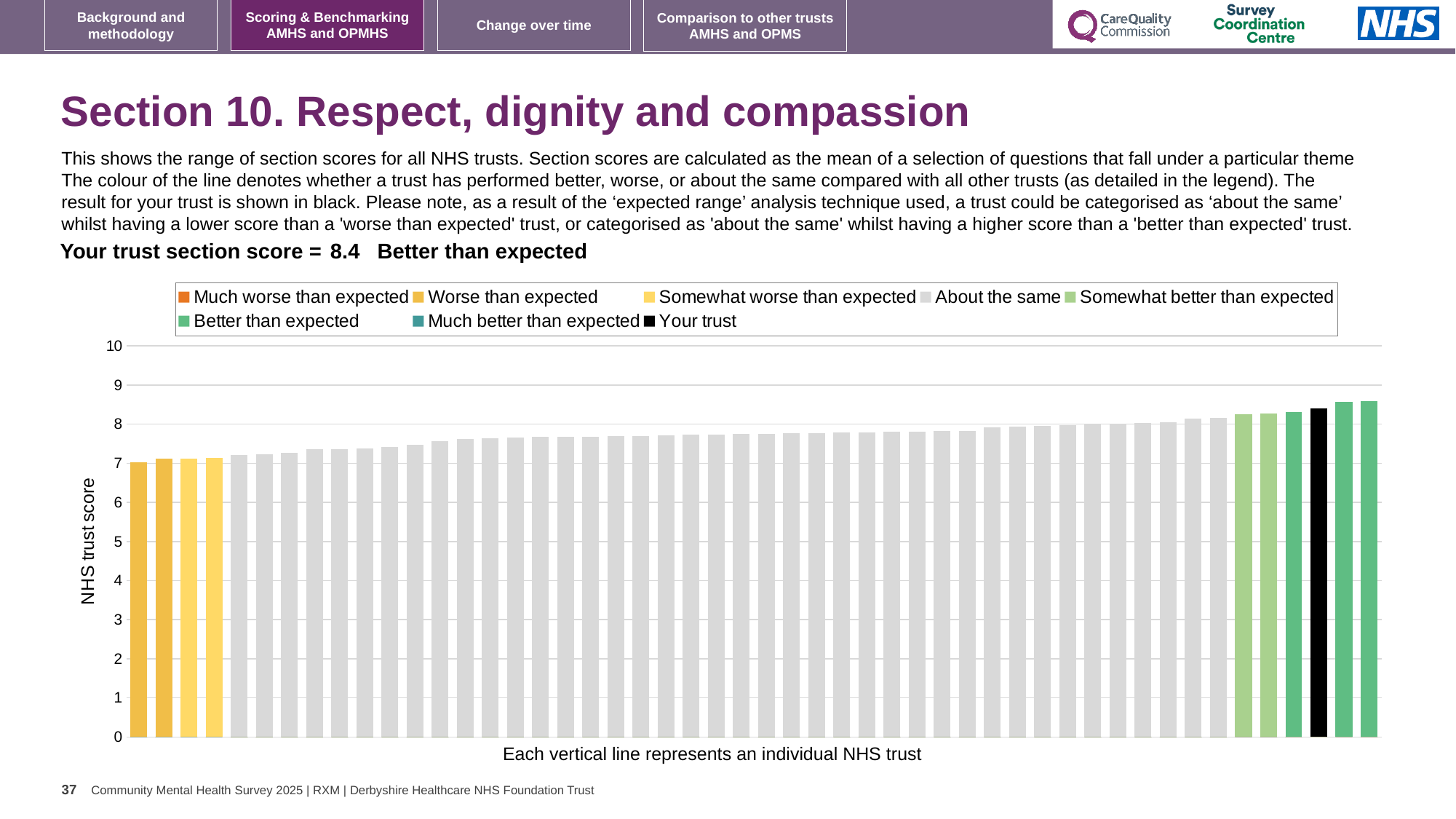
How many bars on the chart are coloured black? 1 What is the label on the vertical axis of the chart? NHS trust score Is the value of the highest bar greater or less than 9? less Do the bar values rise or fall from left to right along the x axis? rise According to the legend, what colour represents 'Your trust'? black Is the black bar for your trust higher or lower than the leftmost bar? higher What is the section score for your trust? 8.4 Is the value of the leftmost (lowest) bar greater or less than 6? greater What kind of chart is shown on the slide? bar chart Is the value for your trust (the black bar) greater or less than 8? greater How many entries does the chart legend list? 8 Which performance category is your trust placed in for this section? Better than expected